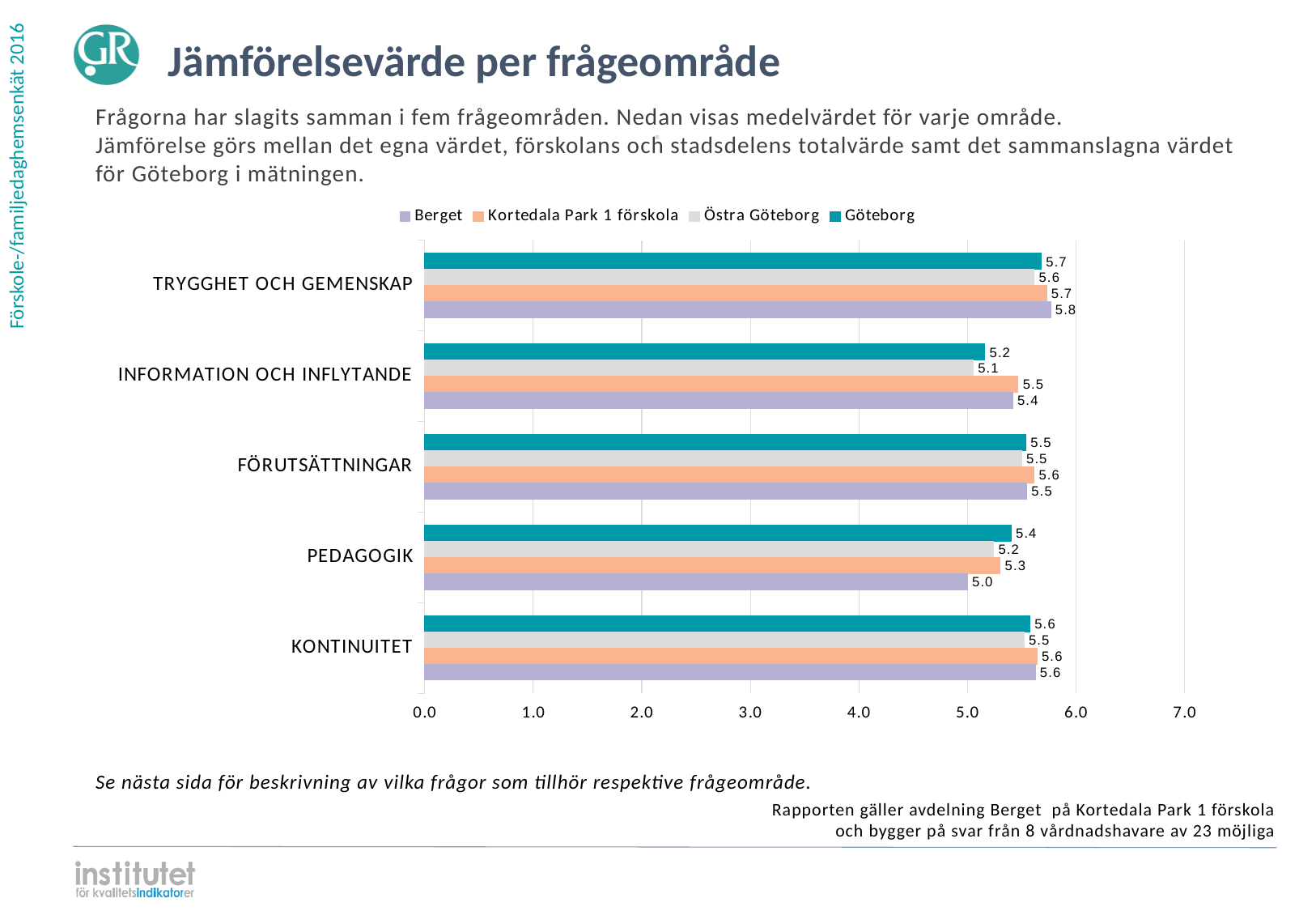
What is the value for Kortedala Park 1 förskola in the INFORMATION OCH INFLYTANDE category? 5.5 How many series does the legend list? 4 How many question areas (categories) are shown on the chart? 5 In the INFORMATION OCH INFLYTANDE category, which is larger: the value for Kortedala Park 1 förskola or the value for Östra Göteborg? Kortedala Park 1 förskola What kind of chart is shown on the slide? Bar chart What is the value for Berget in the PEDAGOGIK category? 5.0 What is the difference between the Berget value and the Göteborg value in the PEDAGOGIK category? 0.4 In which category does Berget have its lowest value? PEDAGOGIK In which category does Berget have its highest value? TRYGGHET OCH GEMENSKAP What is the value for Göteborg in the TRYGGHET OCH GEMENSKAP category? 5.7 Is the value for Berget in the TRYGGHET OCH GEMENSKAP category greater or less than 5.0? greater What is the value for Östra Göteborg in the KONTINUITET category? 5.5